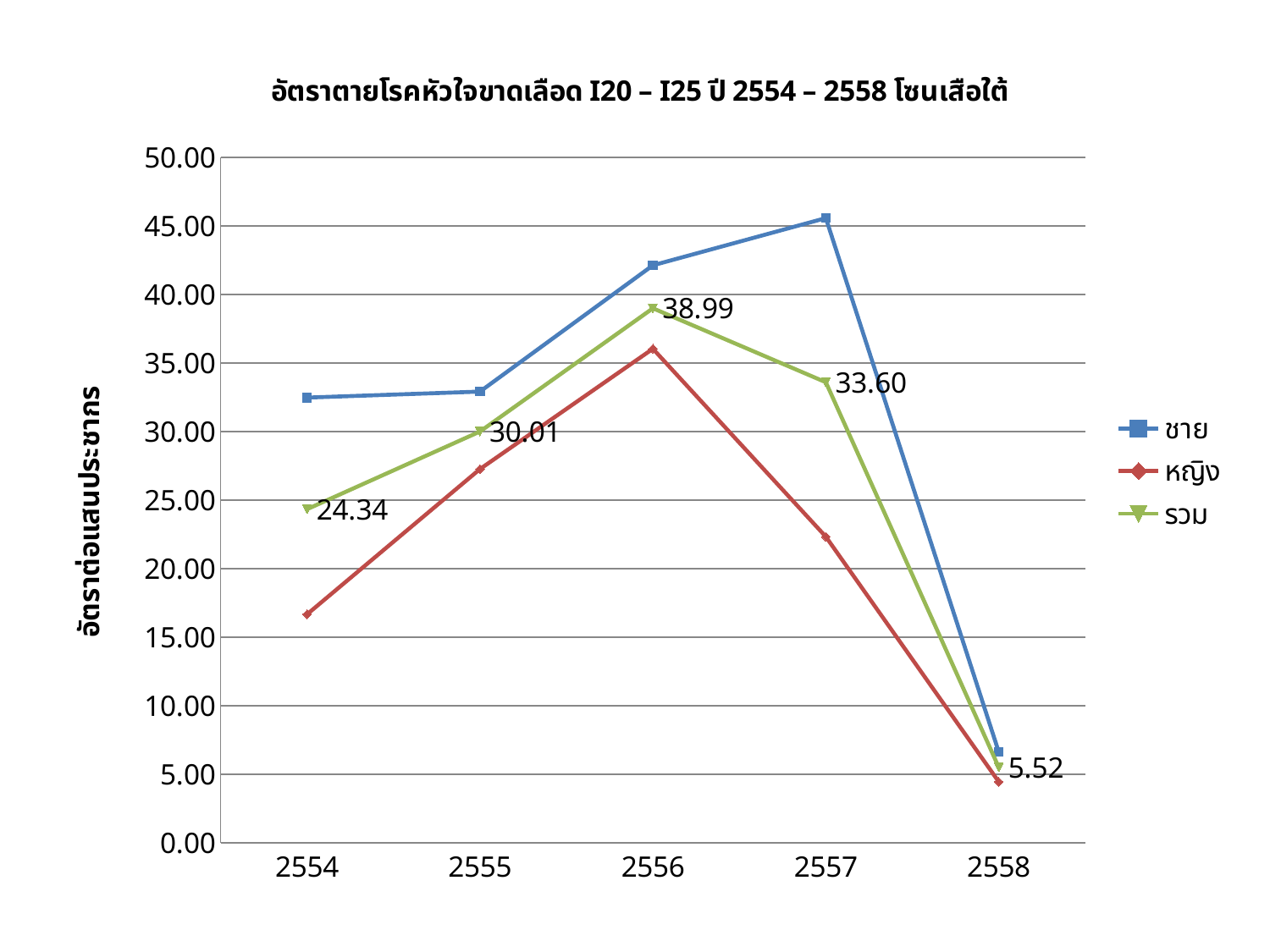
What is the difference between the รวม values for 2556 and 2557? 5.39 Is the value for ชาย in 2557 greater or less than 40.00? greater What is the value for รวม in 2558? 5.52 Which is larger for รวม: the value in 2555 or the value in 2557? 2557 How many years are shown on the x axis? 5 In which year is the รวม series lowest? 2558 What kind of chart is shown on the slide? line chart What is the value for รวม in 2556? 38.99 In which year is the รวม series highest? 2556 What is the value for รวม in 2554? 24.34 Is the value for หญิง in 2554 greater or less than 20.00? less How many series does the legend list? 3